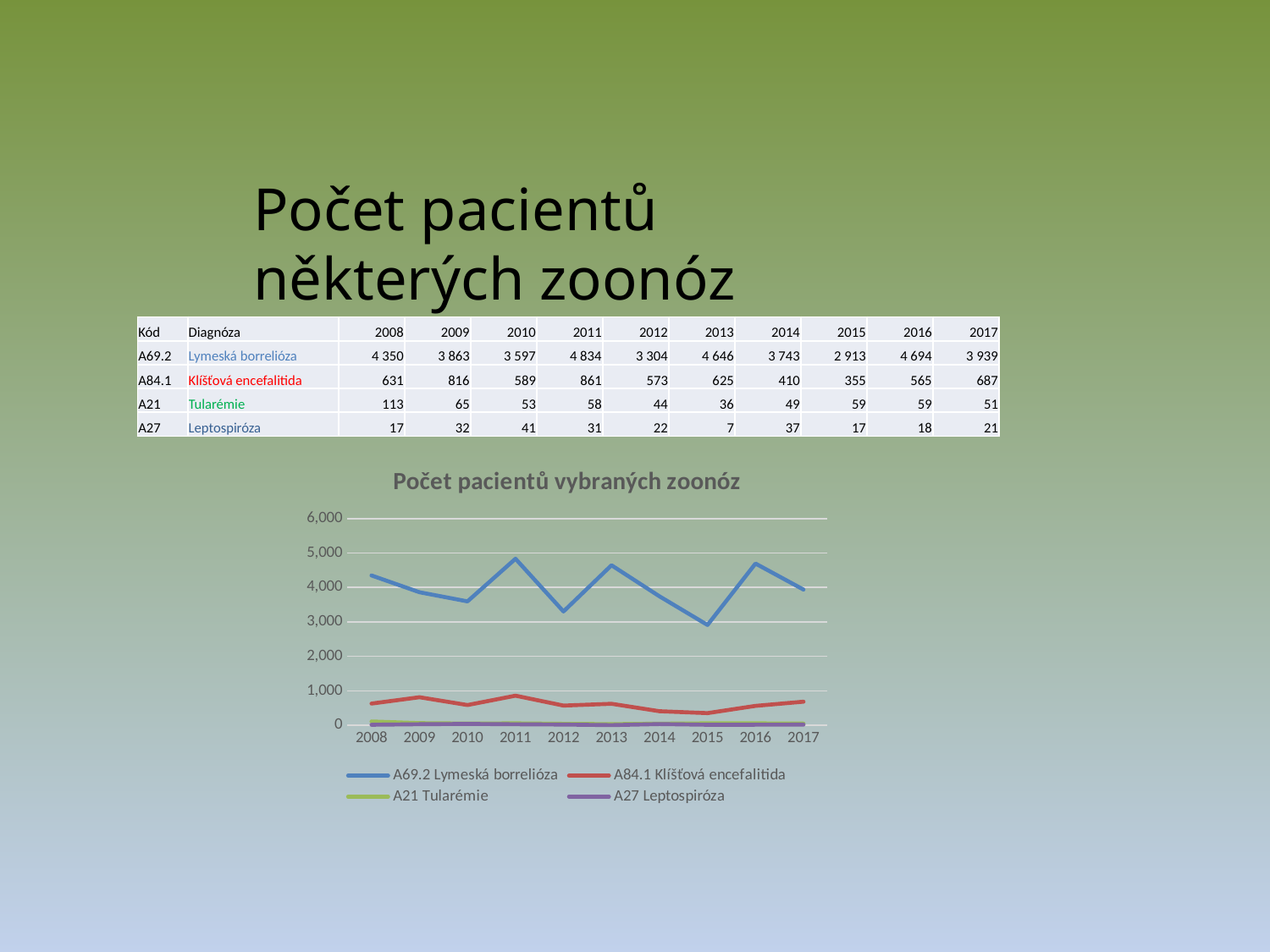
What is the title of the chart? Počet pacientů vybraných zoonóz In which year is the value for A84.1 Klíšťová encefalitida highest? 2011 Is the value for A69.2 Lymeská borrelióza in 2015 greater or less than 3,000? less In which year is the value for A69.2 Lymeská borrelióza lowest? 2015 Which series has the higher value in 2012, A69.2 Lymeská borrelióza or A84.1 Klíšťová encefalitida? A69.2 Lymeská borrelióza What is the difference between the A69.2 Lymeská borrelióza values in 2011 and 2015? 1 921 What is the value for A69.2 Lymeská borrelióza in 2011? 4 834 How many years are shown on the x axis of the chart? 10 What is the value for A84.1 Klíšťová encefalitida in 2014? 410 Which colour is used for the A84.1 Klíšťová encefalitida line? red How many series does the chart legend list? 4 What kind of chart is shown on the slide? line chart